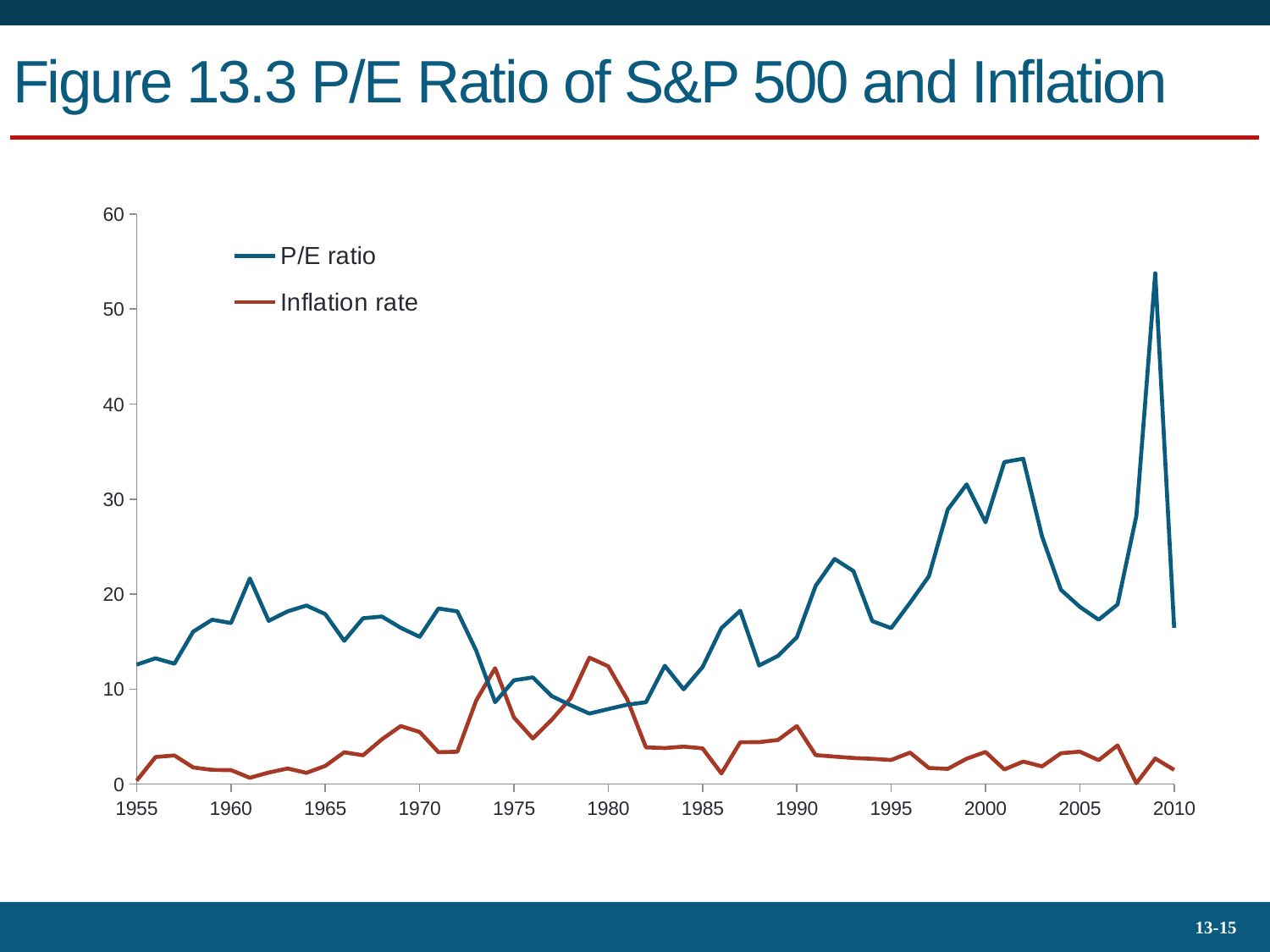
Does the Inflation rate rise or fall between 1980 and 1985? fall In which year does the P/E ratio reach its highest value? 2009 In 1980, which is higher, the P/E ratio or the Inflation rate? Inflation rate Is the Inflation rate in 1980 greater or less than 10? greater Is the P/E ratio in 2009 greater or less than 50? greater How many series does the legend list? 2 In 2000, which is higher, the P/E ratio or the Inflation rate? P/E ratio Is the P/E ratio in 2000 greater or less than 20? greater What are the two series named in the legend? P/E ratio and Inflation rate What kind of chart is shown on the slide? line chart Which colour is used for the Inflation rate line? red